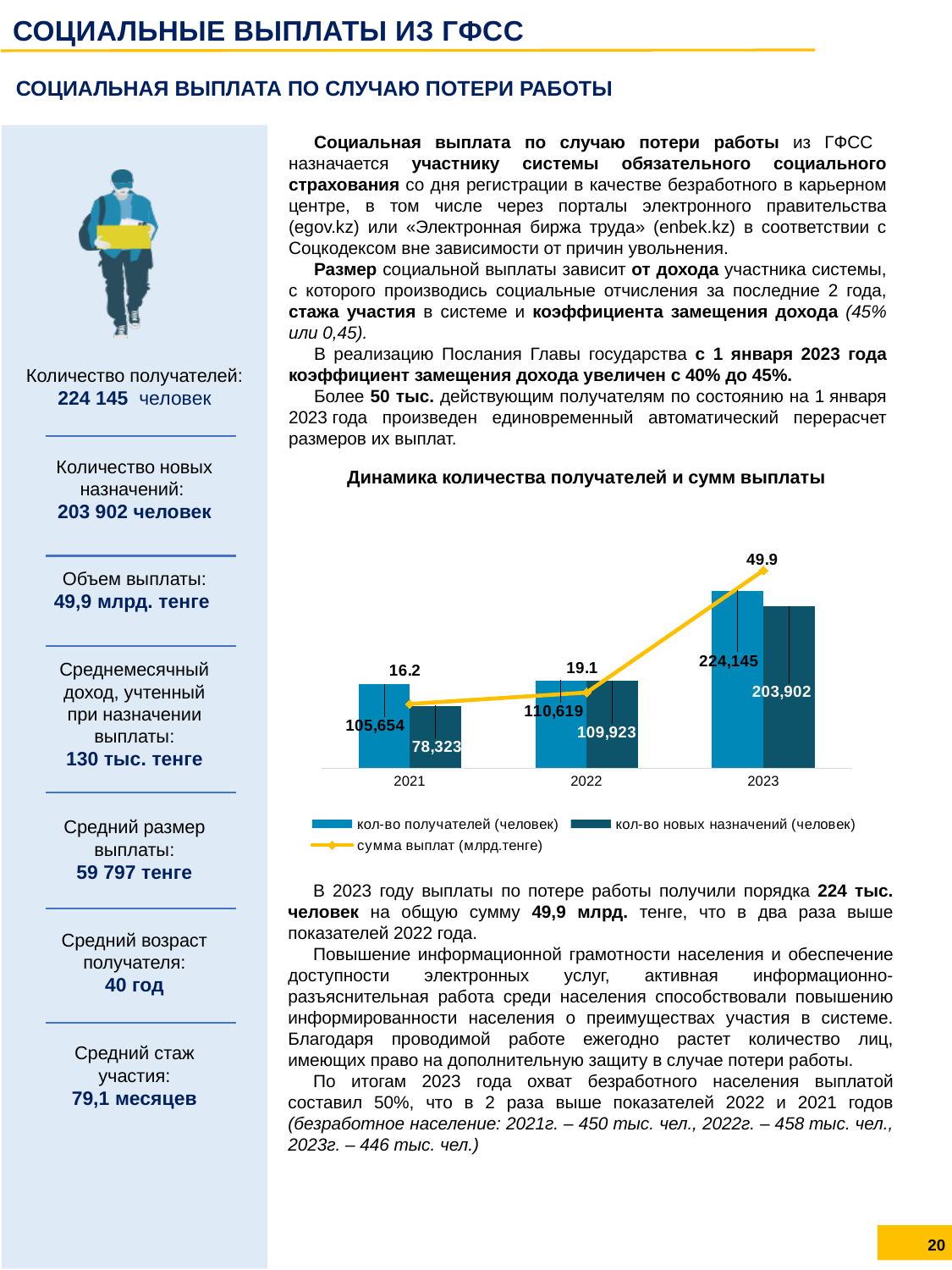
Which year has the highest number of recipients? 2023 In 2021, which is larger: the number of recipients or the number of new assignments? the number of recipients What is the number of new assignments (кол-во новых назначений) in 2021? 78,323 What is the number of recipients (кол-во получателей) in 2023? 224,145 Does the sum of payments rise or fall from 2021 to 2023? rise By how much did the sum of payments (млрд.тенге) increase from 2022 to 2023? 30.8 What is the difference between the number of recipients in 2023 and in 2022? 113,526 How many series does the chart legend list? 3 Which year has the lowest sum of payments? 2021 What kind of chart is used to show the number of recipients and new assignments? bar chart What is the sum of payments (сумма выплат, млрд.тенге) in 2022? 19.1 How many years are shown on the x axis of the chart? 3